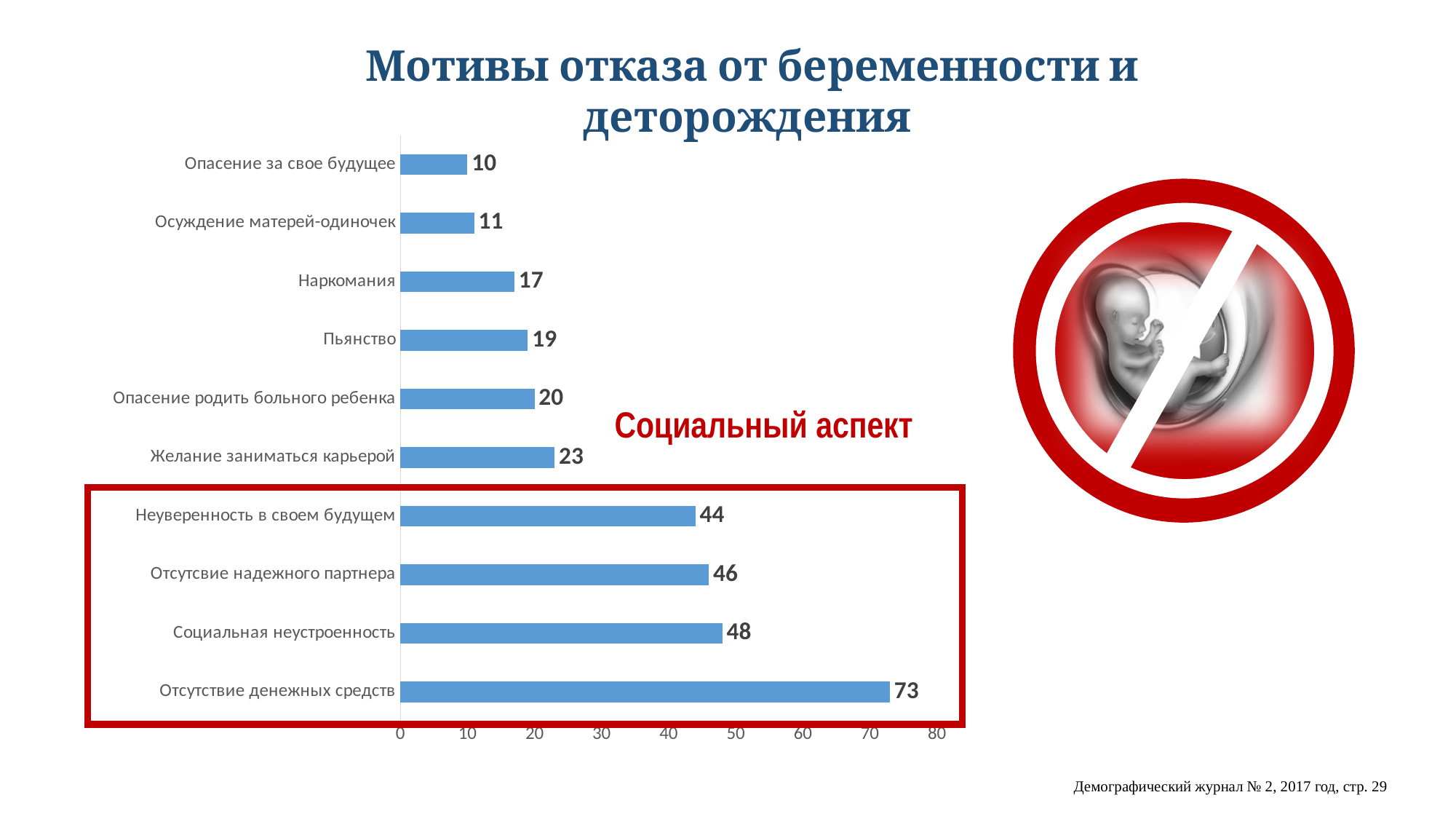
Which is larger, the value for Отсутсвие надежного партнера or the value for Опасение родить больного ребенка? Отсутсвие надежного партнера What is the value for Отсутствие денежных средств? 73 What kind of chart is shown on the slide? bar chart What is the difference between the values for Отсутствие денежных средств and Социальная неустроенность? 25 What is the title of the slide? Мотивы отказа от беременности и деторождения Is the value for Социальная неустроенность greater or less than 40? greater What is the difference between the values for Неуверенность в своем будущем and Пьянство? 25 Which category has the lowest value? Опасение за свое будущее How many categories are shown in the chart? 10 What is the value for Наркомания? 17 Which category has the highest value? Отсутствие денежных средств What is the value for Желание заниматься карьерой? 23